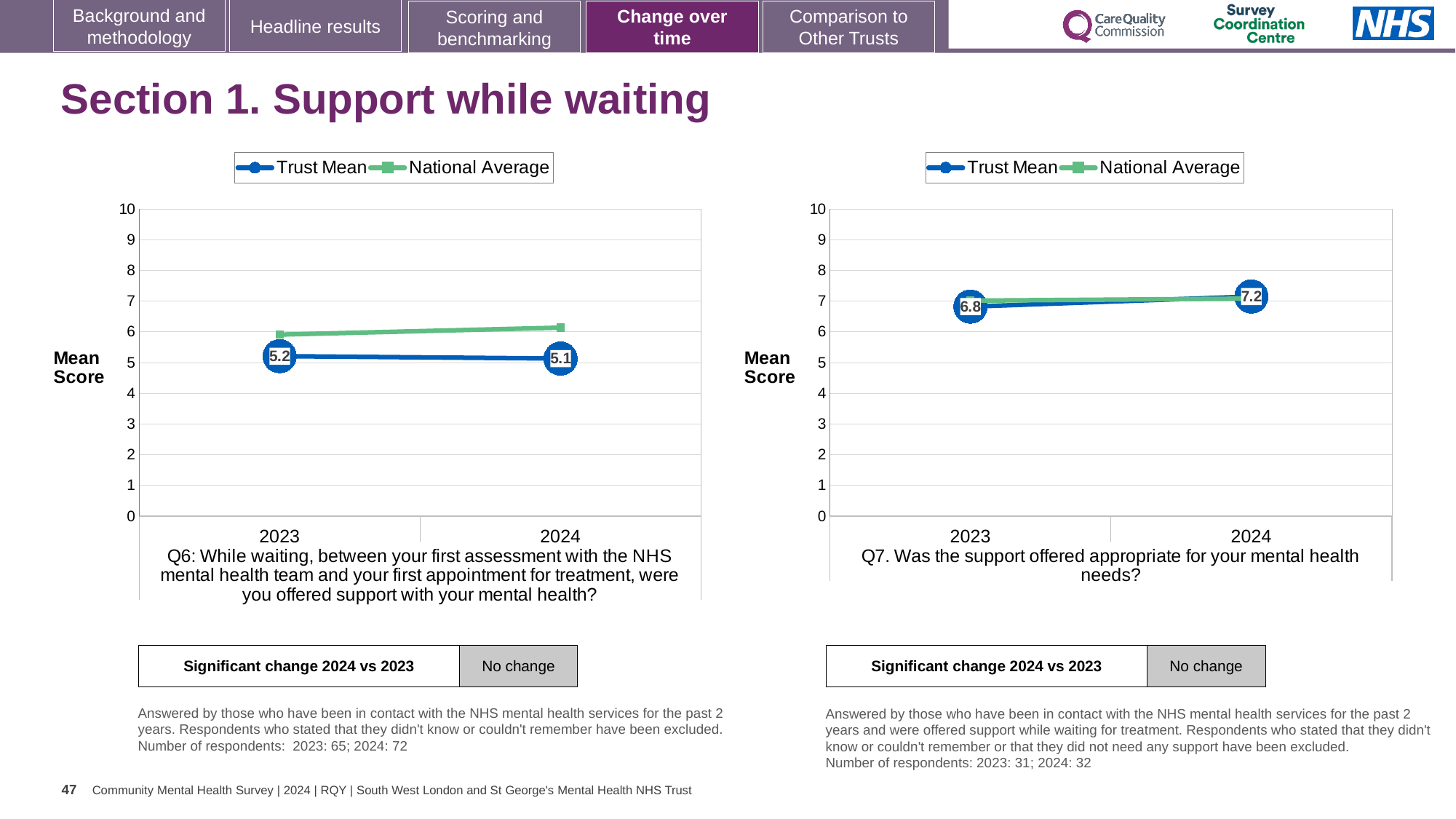
In the left chart (Q6), what is the Trust Mean for 2024? 5.1 In the right chart (Q7), what is the Trust Mean for 2023? 6.8 In the left chart (Q6), which is higher in 2024, the Trust Mean or the National Average? National Average In the left chart (Q6), does the Trust Mean rise or fall from 2023 to 2024? fall In the left chart (Q6), what is the Trust Mean for 2023? 5.2 In the right chart (Q7), what is the Trust Mean for 2024? 7.2 What kind of chart is used on this slide? line chart In the left chart (Q6), is the National Average for 2023 greater or less than 5? greater In the right chart (Q7), by how much did the Trust Mean change from 2023 to 2024? 0.4 How many series does the legend of the right chart (Q7) list? 2 How many years are plotted on the x axis of the left chart (Q6)? 2 In the right chart (Q7), does the Trust Mean rise or fall from 2023 to 2024? rise